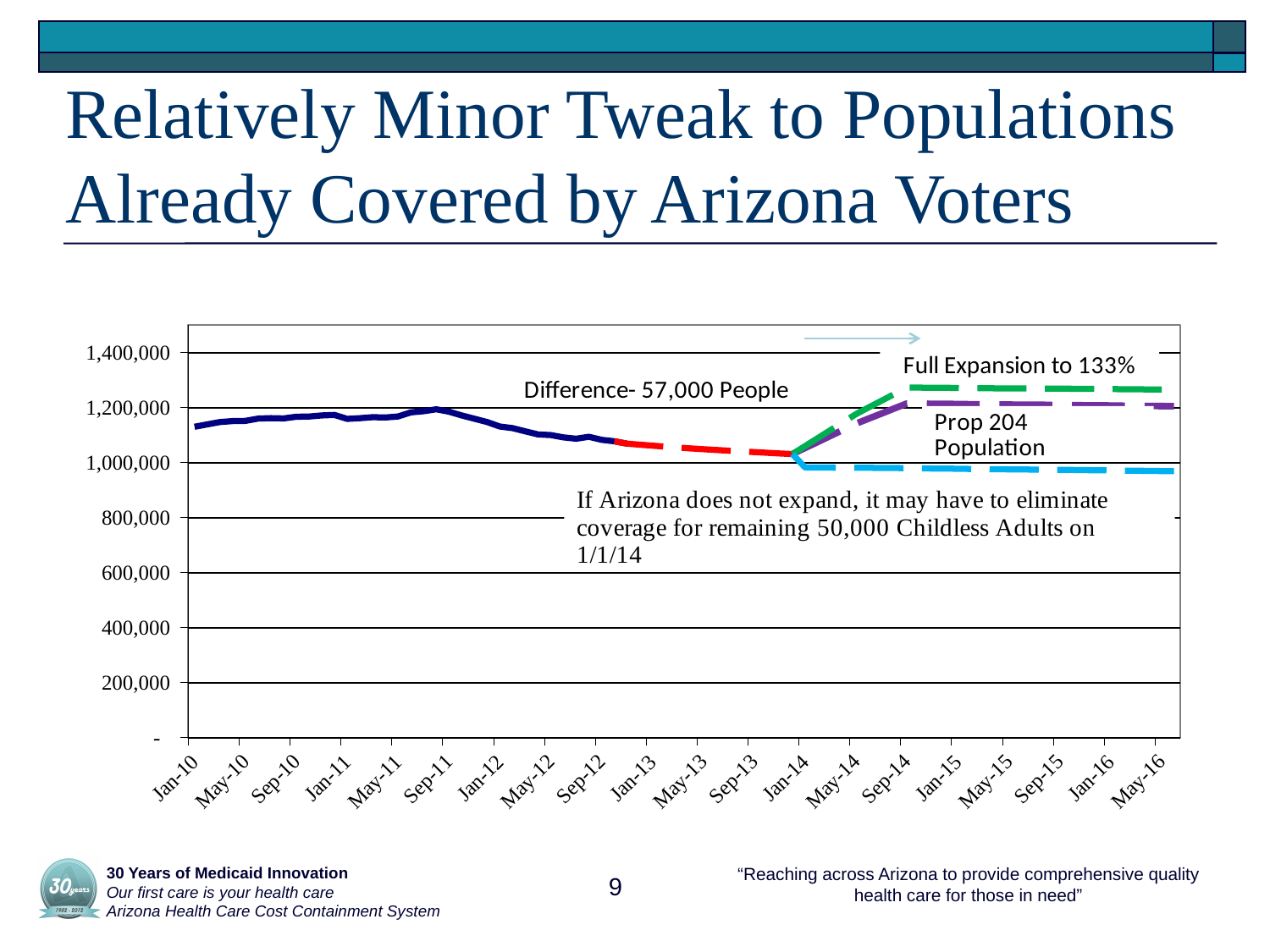
Does the green 'Full Expansion to 133%' line rise or fall from Jan-14 to Sep-14? rise Is the value for Jan-14 greater or less than 1,200,000? less Which is higher: the value at Sep-11 or the value at Jan-14? Sep-11 Is the value of the green 'Full Expansion to 133%' line at Jan-15 greater or less than 1,200,000? greater Is the value for Sep-11 greater or less than 1,000,000? greater What kind of chart is shown on the slide? line chart At May-16, which is higher: the green 'Full Expansion to 133%' line or the light blue bottom line? the green 'Full Expansion to 133%' line What difference in people is noted in the annotation on the chart? 57,000 People Do the values rise or fall along the x axis from Sep-11 to Jan-14? fall